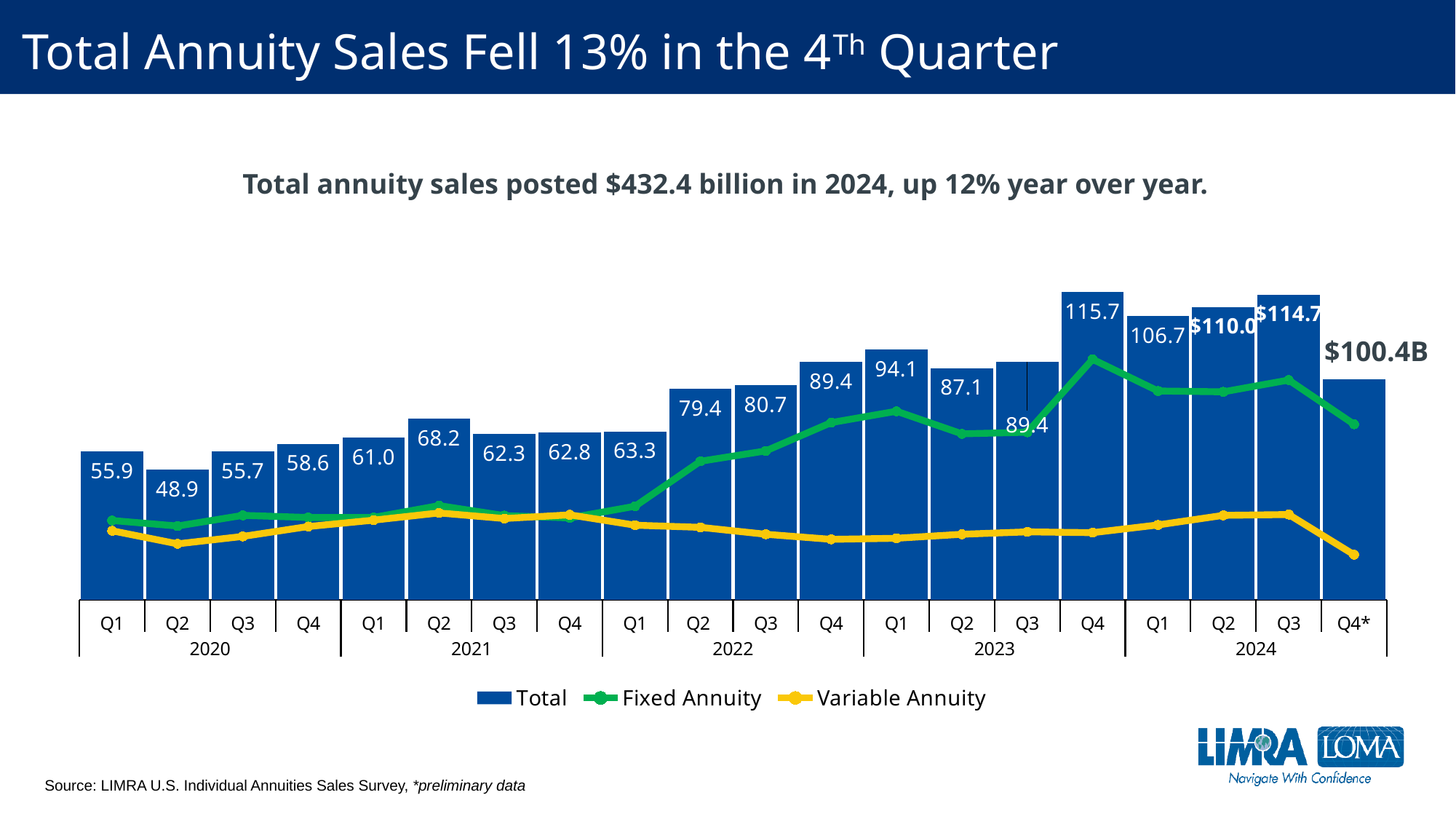
What is the Total value for Q4 2023? 115.7 Which is larger, the Total value for Q2 2021 or Q1 2022? Q2 2021 What is the Total value for Q3 2024? $114.7 How many series does the legend list? 3 How many quarters are shown on the x axis? 20 What is the Total value for Q2 2020? 48.9 Which quarter has the highest Total value? Q4 2023 What is the difference between the Total values for Q4 2023 and Q1 2024? 9.0 Which quarter has the lowest Total value? Q2 2020 What is the Total value labeled for Q4* 2024? $100.4B Does the Fixed Annuity line rise or fall from Q1 2022 to Q4 2023? rise What kind of chart is used to show the Total series? bar chart